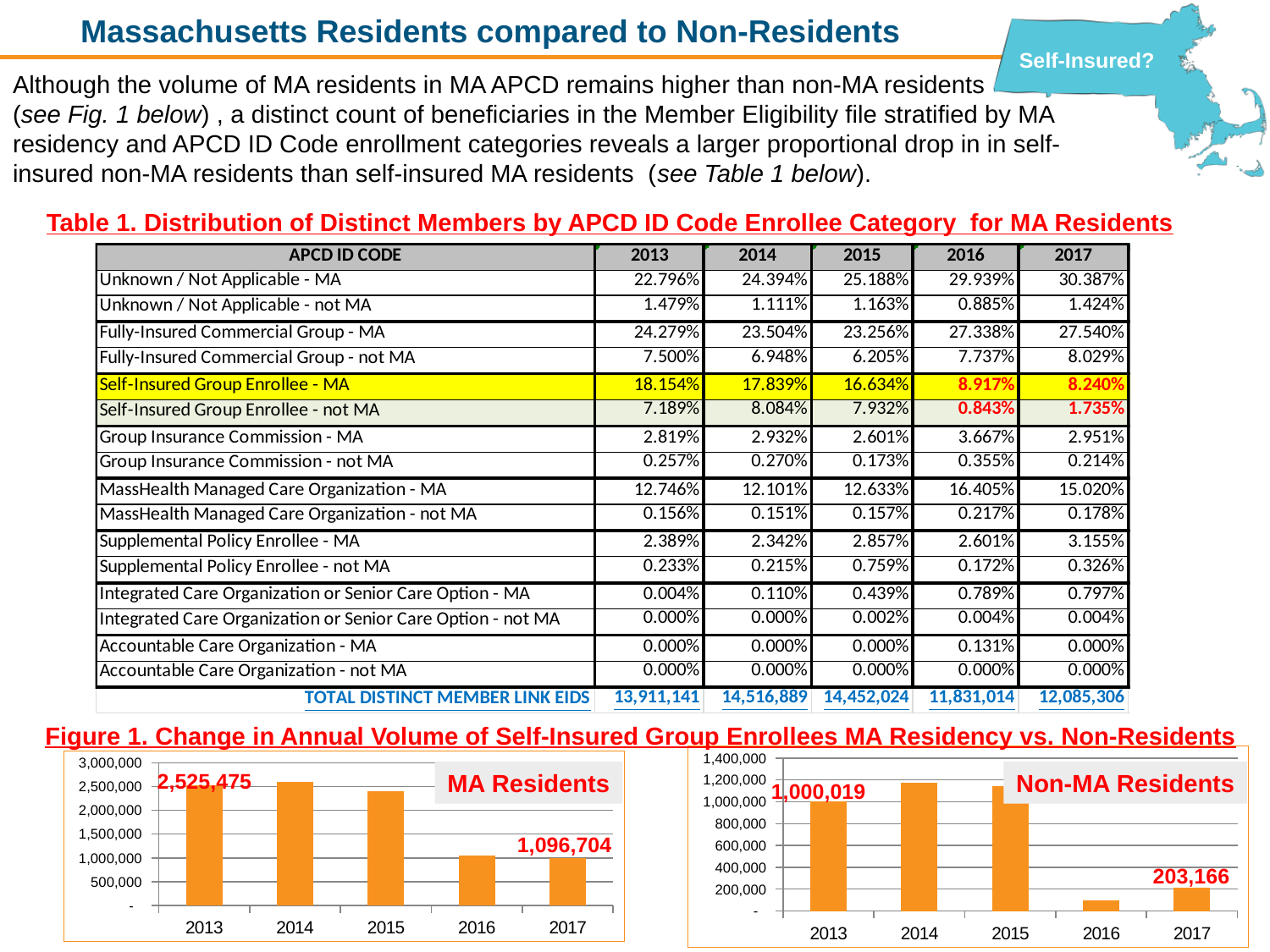
How many years are shown on the x axis of the MA Residents chart? 5 In the Non-MA Residents chart, what is the value for 2017? 203,166 In the Non-MA Residents chart, what is the value for 2013? 1,000,019 In the Non-MA Residents chart, is the value for 2014 greater or less than 1,000,000? greater In the Non-MA Residents chart, which year has the lowest value? 2016 In the Non-MA Residents chart, what is the difference between the 2013 and 2017 values? 796,853 Which is larger: the 2013 value in the MA Residents chart or the 2013 value in the Non-MA Residents chart? MA Residents In the MA Residents chart, what is the difference between the 2013 and 2017 values? 1,428,771 In the MA Residents chart, what is the value for 2017? 1,096,704 In the MA Residents chart, is the value for 2016 greater or less than 1,500,000? less In the MA Residents chart, what is the value for 2013? 2,525,475 What kind of chart is the Non-MA Residents chart? bar chart